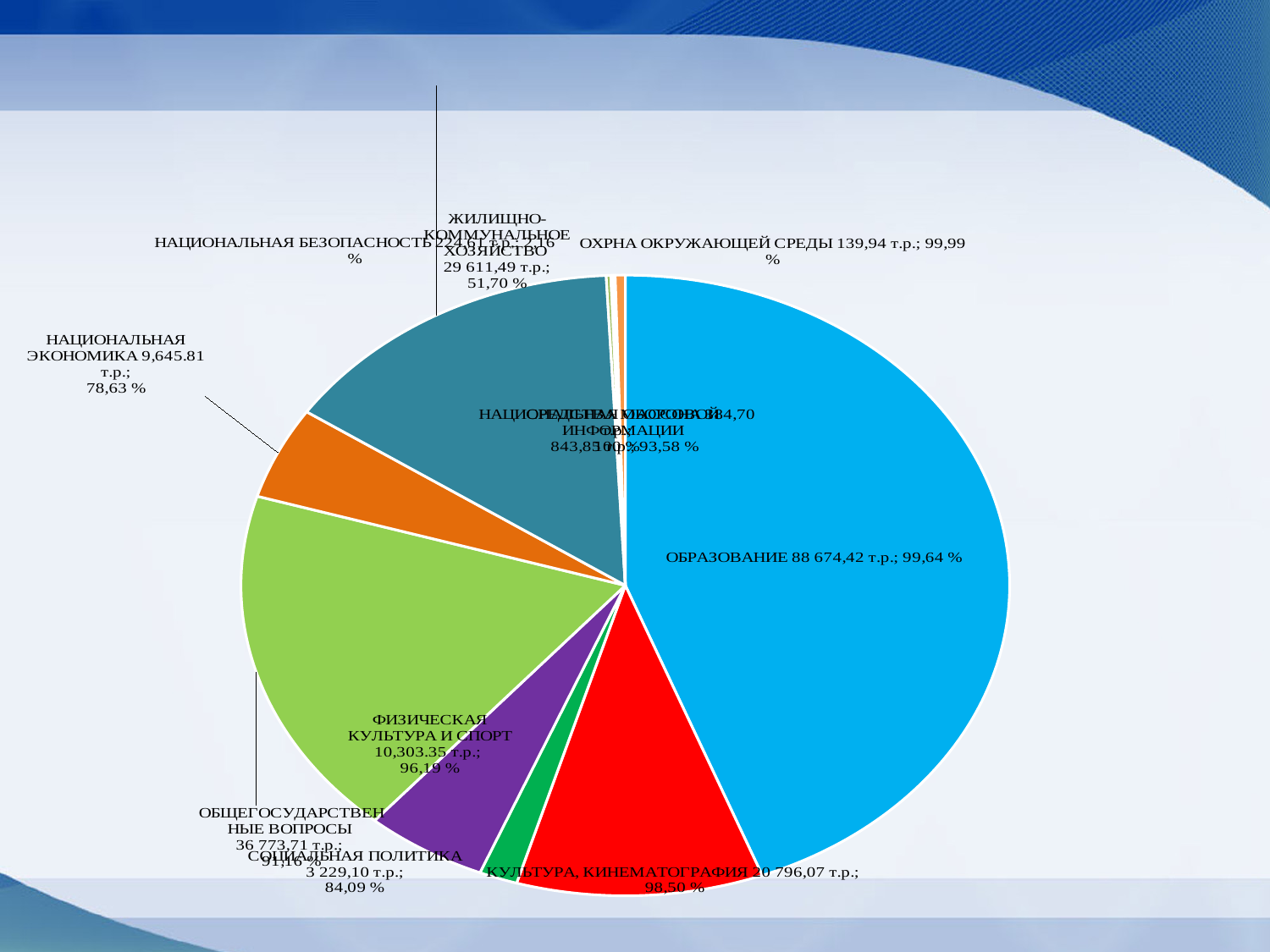
What percentage is shown for НАЦИОНАЛЬНАЯ ЭКОНОМИКА? 78,63 % What is the difference in т.р. between ОБРАЗОВАНИЕ and КУЛЬТУРА, КИНЕМАТОГРАФИЯ? 67 878,35 т.р. What value in т.р. is shown for ОБРАЗОВАНИЕ? 88 674,42 т.р. What value in т.р. is shown for КУЛЬТУРА, КИНЕМАТОГРАФИЯ? 20 796,07 т.р. What percentage is shown for ЖИЛИЩНО-КОММУНАЛЬНОЕ ХОЗЯЙСТВО? 51,70 % What percentage is shown for ОБРАЗОВАНИЕ? 99,64 % What value in т.р. is shown for ОХРАНА ОКРУЖАЮЩЕЙ СРЕДЫ? 139,94 т.р. What colour is the ОБРАЗОВАНИЕ slice? light blue What kind of chart is shown on the slide? pie chart What percentage is shown for СОЦИАЛЬНАЯ ПОЛИТИКА? 84,09 % Which category has the largest slice of the pie? ОБРАЗОВАНИЕ Which has the larger value in т.р.: ОБРАЗОВАНИЕ or КУЛЬТУРА, КИНЕМАТОГРАФИЯ? ОБРАЗОВАНИЕ